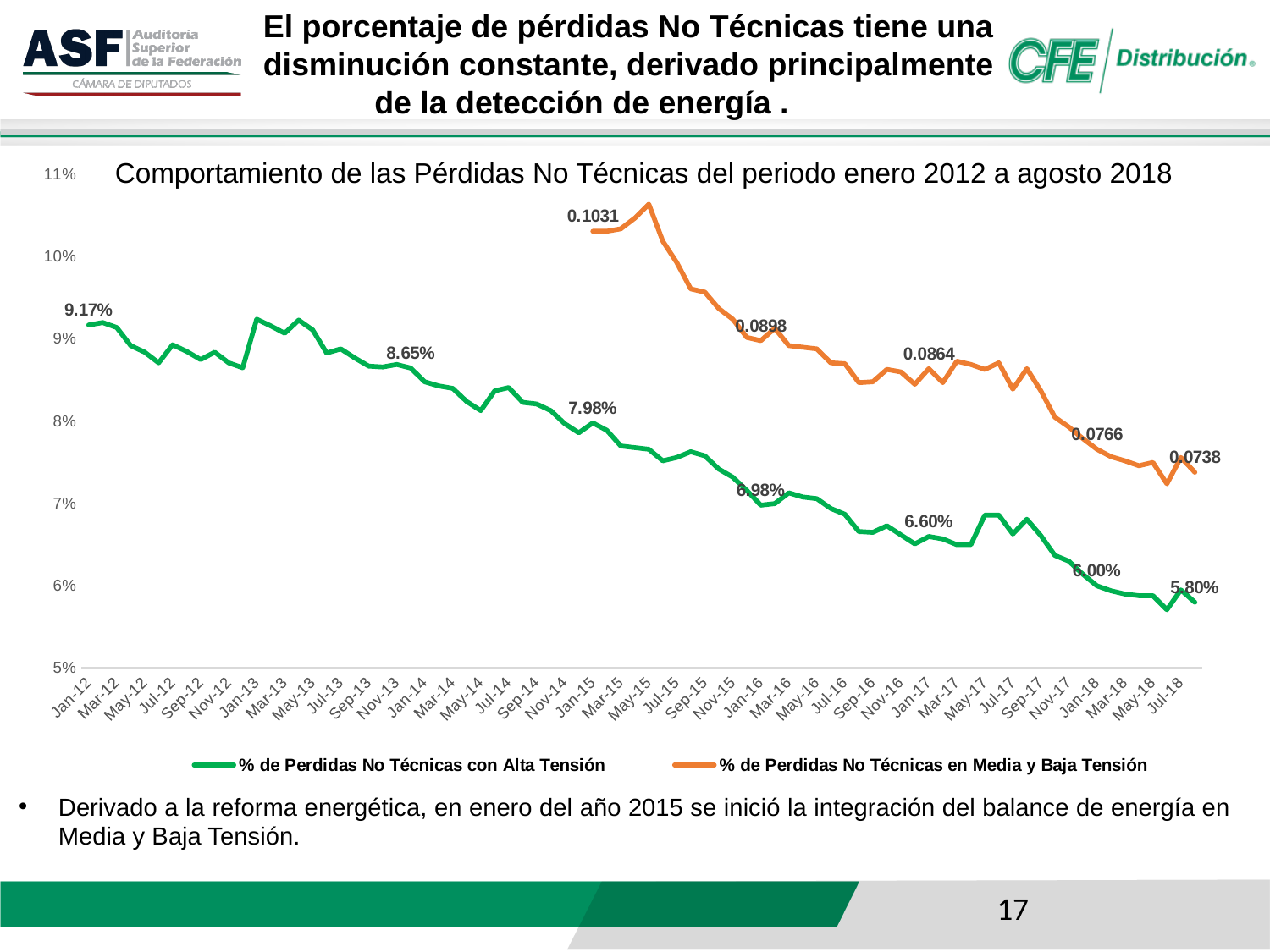
What is the difference between the first (9.17%) and last (5.80%) labeled values of the green Alta Tensión line? 3.37% Do the values of the green line (Alta Tensión) rise or fall overall from Jan-12 to Jul-18? fall What is the title of the chart? Comportamiento de las Pérdidas No Técnicas del periodo enero 2012 a agosto 2018 Do the values of the orange line (Media y Baja Tensión) rise or fall overall from Jan-15 to Jul-18? fall How many series does the chart legend list? 2 What is the last data label shown on the green line (% de Perdidas No Técnicas con Alta Tensión)? 5.80% What kind of chart is shown on the slide? line chart What is the first data label shown on the green line (% de Perdidas No Técnicas con Alta Tensión), at Jan-12? 9.17% Is the value of the orange Media y Baja Tensión line at Jul-18 greater or less than 8%? less Which series has the higher value at Jan-16: Alta Tensión or Media y Baja Tensión? Media y Baja Tensión What is the last data label shown on the orange line (% de Perdidas No Técnicas en Media y Baja Tensión)? 0.0738 What is the first data label shown on the orange line (% de Perdidas No Técnicas en Media y Baja Tensión), at Jan-15? 0.1031